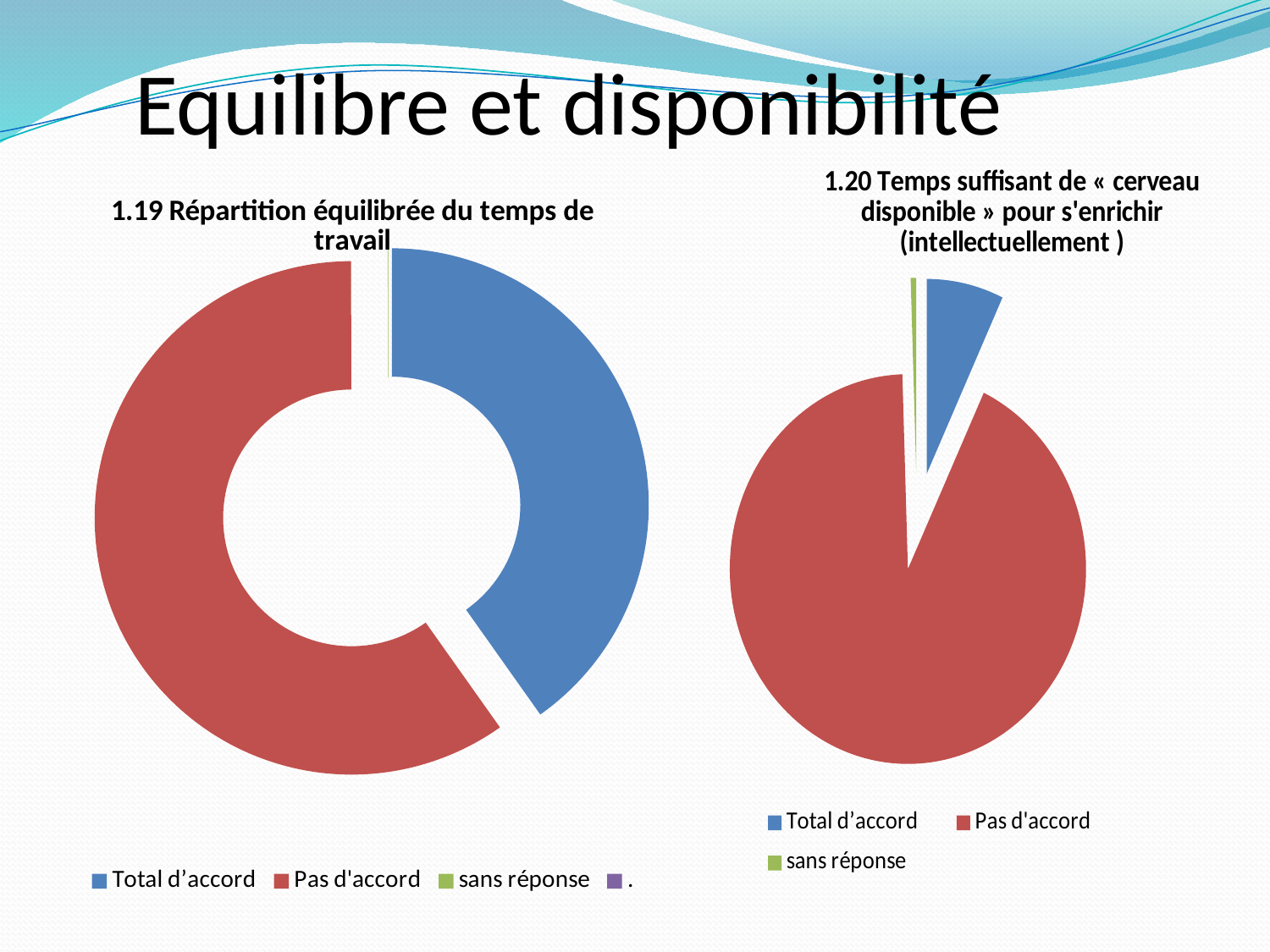
In the left chart '1.19 Répartition équilibrée du temps de travail', which is larger: Total d'accord or Pas d'accord? Pas d'accord What is the title of the slide? Equilibre et disponibilité In the right chart '1.20 Temps suffisant de « cerveau disponible »', which category has the largest share? Pas d'accord What kind of chart is the left chart, '1.19 Répartition équilibrée du temps de travail'? doughnut chart What kind of chart is the right chart, '1.20 Temps suffisant de « cerveau disponible » pour s'enrichir (intellectuellement )'? pie chart How many entries does the legend of the right chart '1.20 Temps suffisant de « cerveau disponible »' list? 3 In the right chart '1.20 Temps suffisant de « cerveau disponible »', which is larger: Total d'accord or sans réponse? Total d'accord How many entries does the legend of the left chart '1.19 Répartition équilibrée du temps de travail' list? 4 In the left chart '1.19 Répartition équilibrée du temps de travail', which is larger: Total d'accord or sans réponse? Total d'accord In the left chart '1.19 Répartition équilibrée du temps de travail', which category has the largest share? Pas d'accord What colour represents 'Pas d'accord' in the right chart '1.20 Temps suffisant de « cerveau disponible »'? red In the right chart '1.20 Temps suffisant de « cerveau disponible »', which category has the smallest share? sans réponse